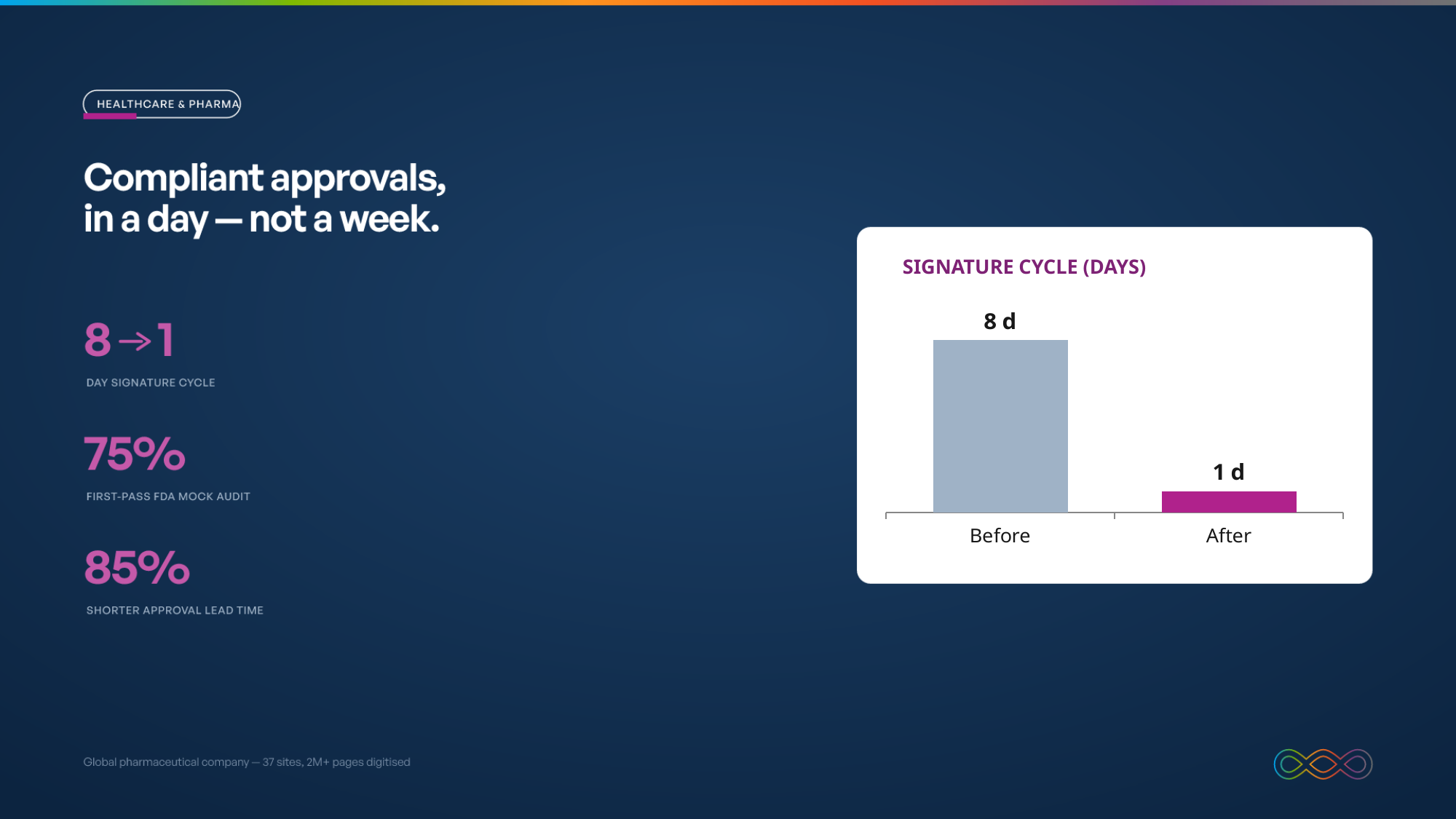
What kind of chart is the Signature Cycle chart? Bar chart Which category has the lowest value in the Signature Cycle chart? After Do the values rise or fall from Before to After in the Signature Cycle chart? Fall What is the value for After in the Signature Cycle chart? 1 d What is the difference between the Before and After values in the Signature Cycle chart? 7 d How many categories are shown in the Signature Cycle chart? 2 What colour is the After bar in the Signature Cycle chart? Magenta What is the value for Before in the Signature Cycle chart? 8 d Which category has the highest value in the Signature Cycle chart? Before Which is larger in the Signature Cycle chart, Before or After? Before What is the title of the chart on the slide? SIGNATURE CYCLE (DAYS)